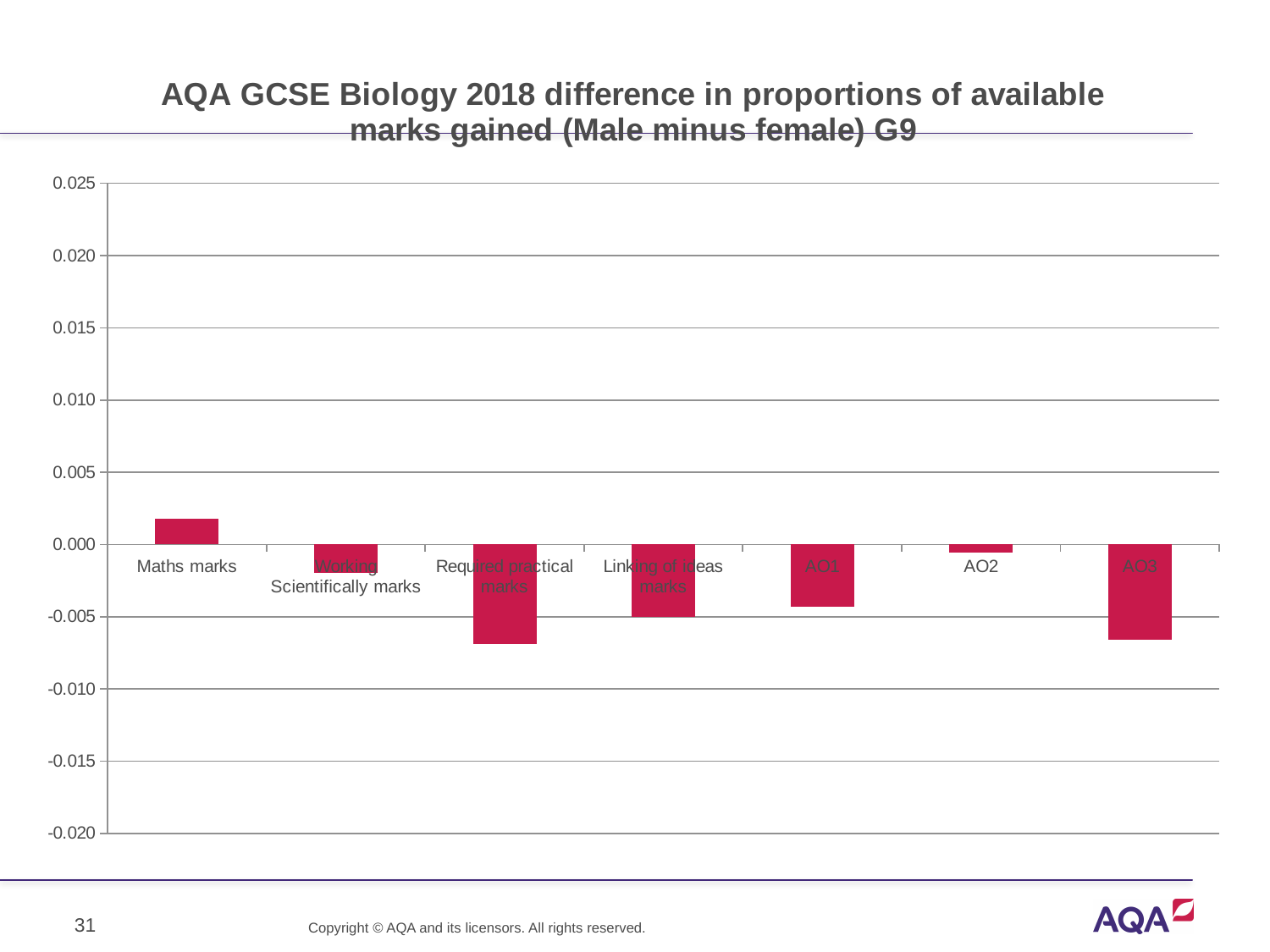
Is the value for Working Scientifically marks greater or less than -0.005? greater What is the title of the chart? AQA GCSE Biology 2018 difference in proportions of available marks gained (Male minus female) G9 Is the value for AO2 greater or less than -0.005? greater Which is the only category with a positive value? Maths marks How many categories are plotted on the chart? 7 What kind of chart is shown on the slide? bar chart Which category has the highest value on the chart? Maths marks Is the value for Maths marks greater or less than 0.005? less Which has the larger value, Working Scientifically marks or Required practical marks? Working Scientifically marks Which has the larger value, Maths marks or AO2? Maths marks